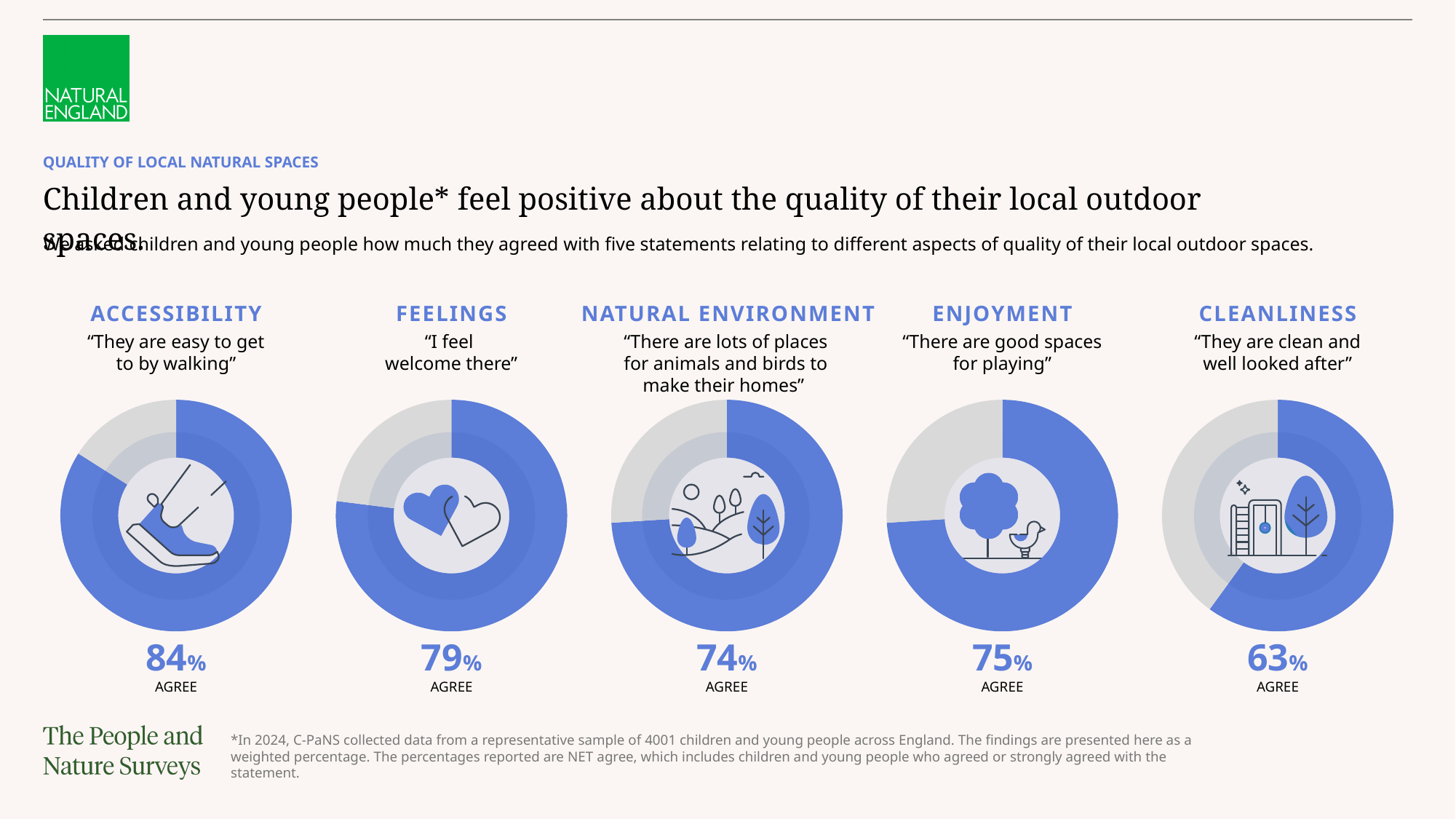
What is the difference in percentage points between the Feelings and Enjoyment agreement values? 4 What percentage of children and young people agree with the Accessibility statement "They are easy to get to by walking"? 84% Which aspect of quality has the highest percentage of agreement? Accessibility Which aspect of quality has the lowest percentage of agreement? Cleanliness Which has a higher agreement percentage, Enjoyment or Natural Environment? Enjoyment What is the difference in percentage points between the Accessibility and Cleanliness agreement values? 21 What percentage agree with the Enjoyment statement "There are good spaces for playing"? 75% What percentage agree with the Natural Environment statement about places for animals and birds to make their homes? 74% What kind of chart is used to show each agreement percentage? Donut chart What percentage agree with the Feelings statement "I feel welcome there"? 79% How many donut charts are shown on the slide? 5 What percentage agree with the Cleanliness statement "They are clean and well looked after"? 63%